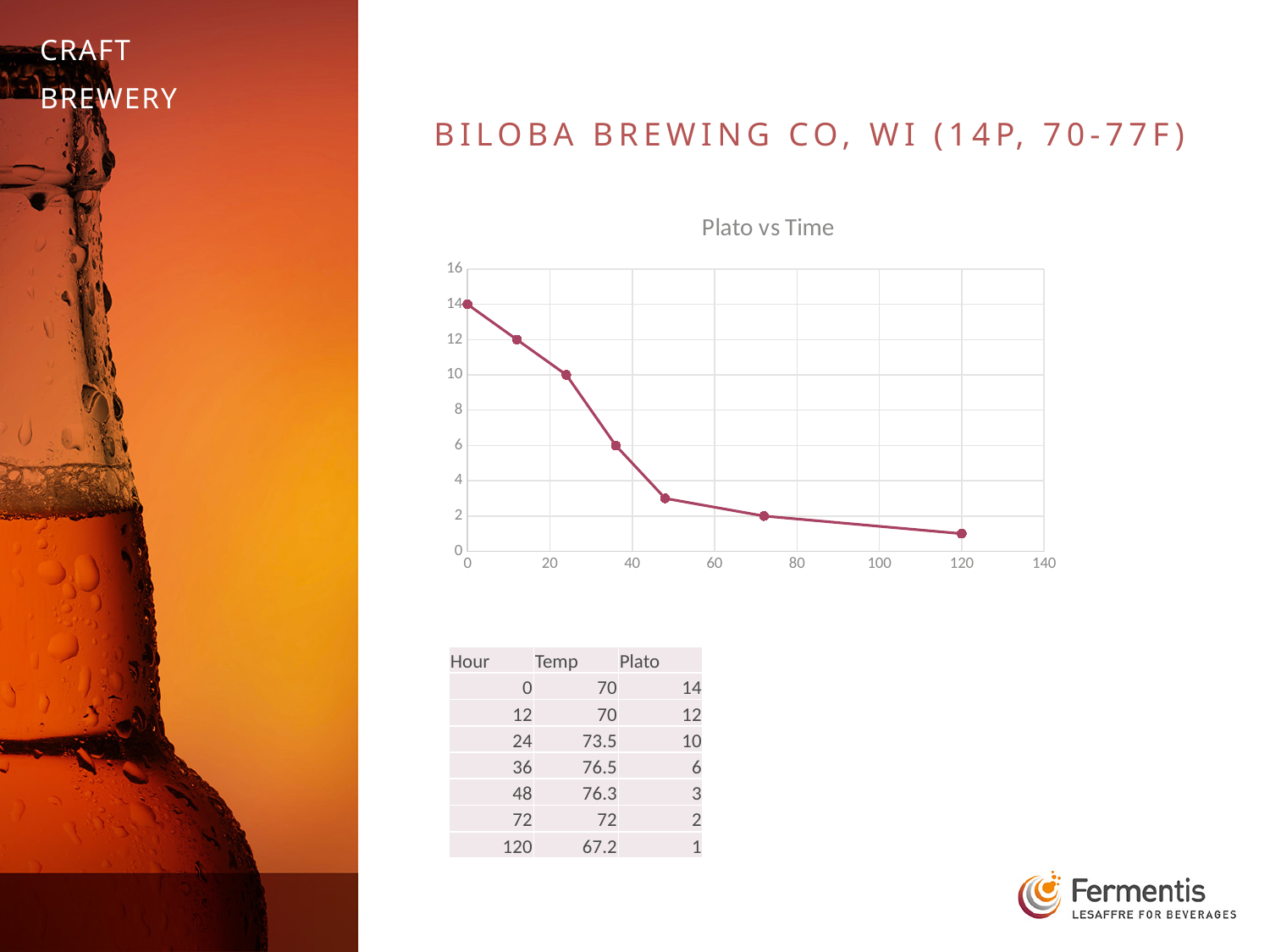
Is the Plato value at hour 48 greater or less than 4? less What kind of chart is shown on the slide? line chart At which hour is the Plato value lowest? 120 At which hour is the Plato value highest? 0 What is the difference in Plato between hour 0 and hour 48? 11 Which has a higher Plato value, hour 24 or hour 72? hour 24 What is the Plato value at hour 120? 1 What is the Plato value at hour 36? 6 Do the Plato values rise or fall as time increases along the x axis? fall What is the title of the chart? Plato vs Time How many data points are plotted on the Plato vs Time chart? 7 What is the Plato value at hour 0? 14